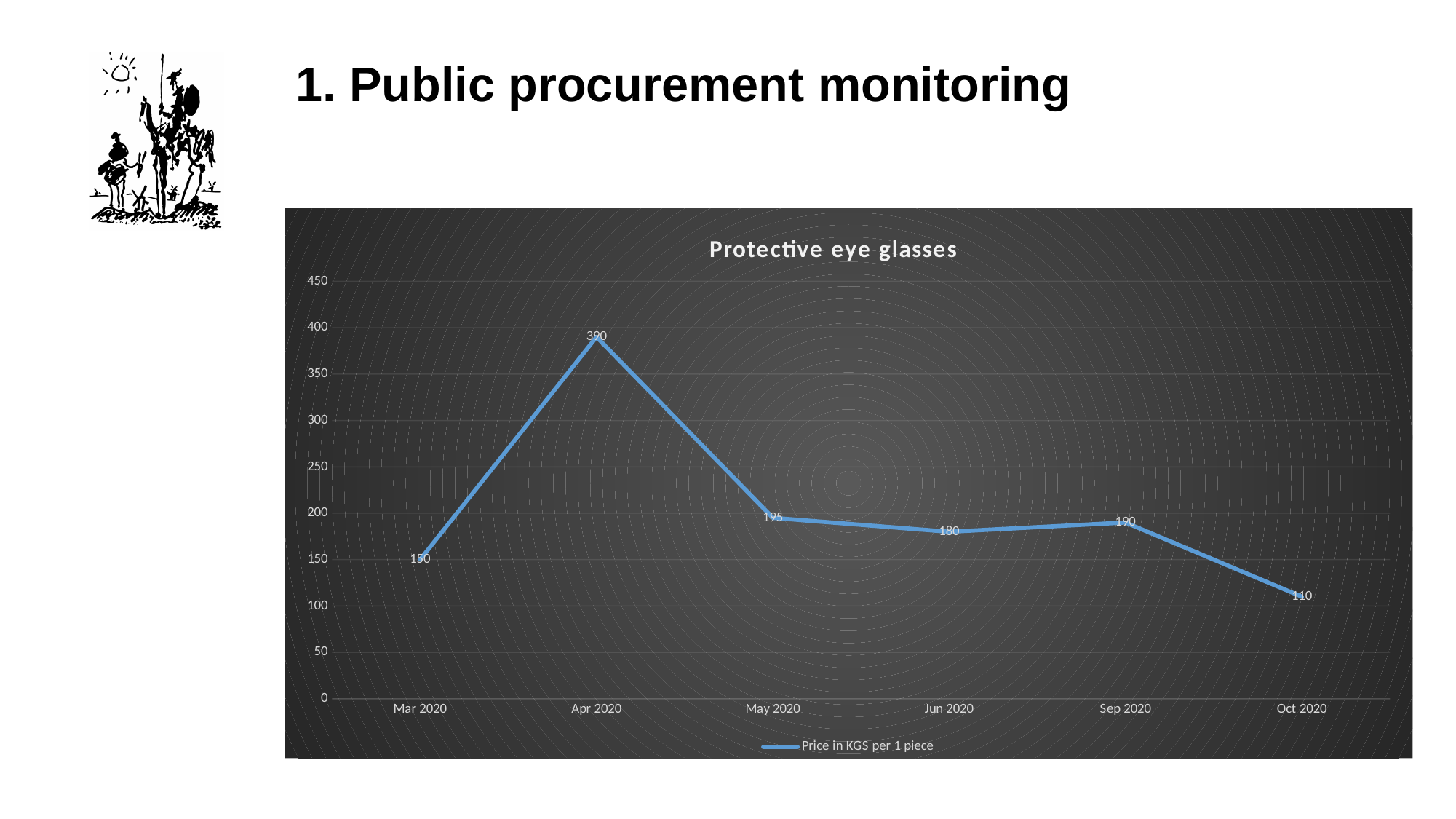
What is the price in KGS per 1 piece for protective eye glasses in Jun 2020? 180 What is the price in KGS per 1 piece for protective eye glasses in Mar 2020? 150 Is the price for protective eye glasses in May 2020 greater or less than 250? less Which month has a higher price for protective eye glasses, Sep 2020 or Jun 2020? Sep 2020 What is the price in KGS per 1 piece for protective eye glasses in Apr 2020? 390 How many months are plotted on the chart? 6 In which month is the price of protective eye glasses highest? Apr 2020 In which month is the price of protective eye glasses lowest? Oct 2020 What is the difference between the price in Apr 2020 and the price in May 2020? 195 What type of chart is shown on the slide? line chart What is the title of the chart? Protective eye glasses What is the price in KGS per 1 piece for protective eye glasses in Oct 2020? 110